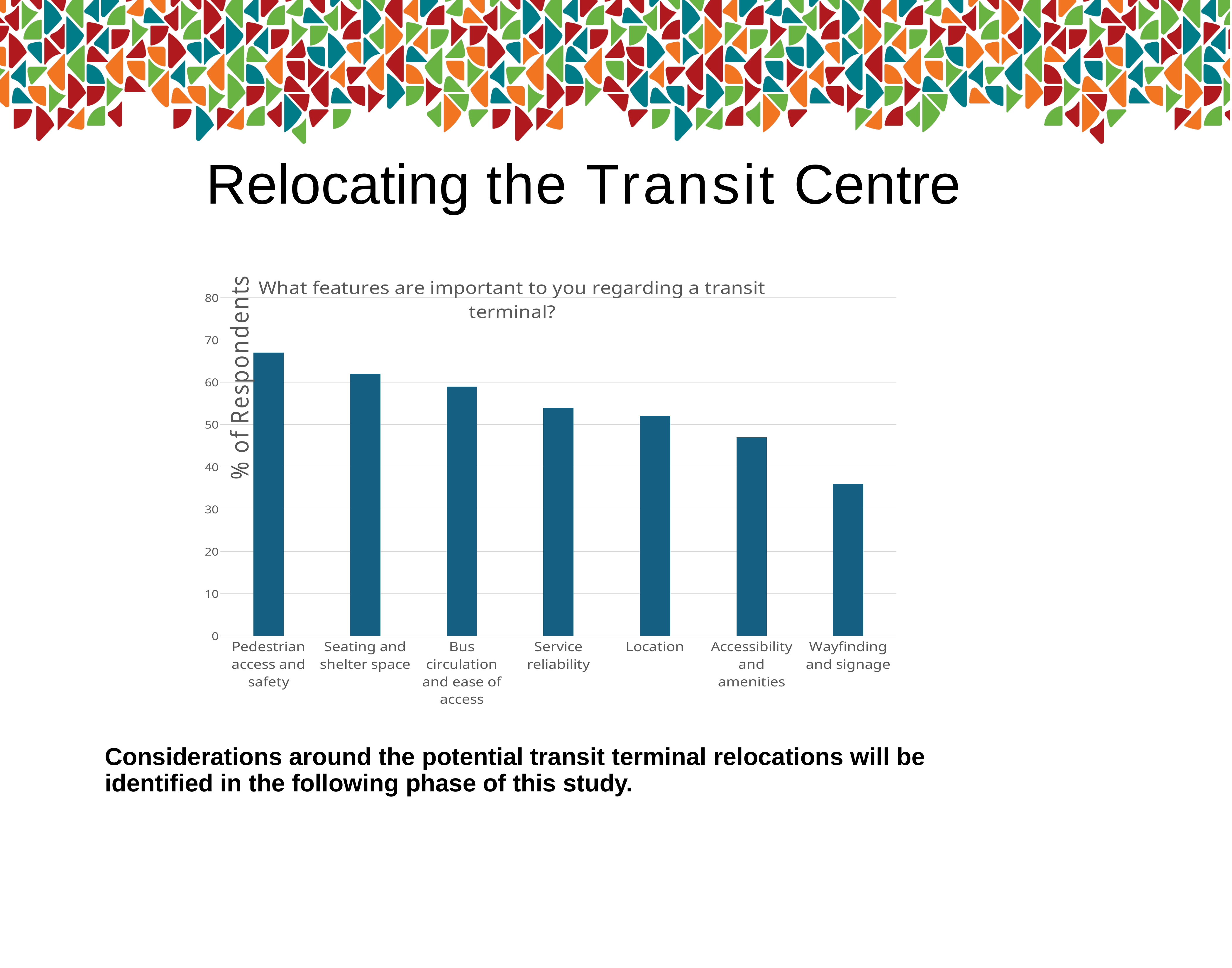
How many features (categories) are shown on the x axis? 7 Do the bar values rise or fall from left to right along the x axis? fall Is the value for Pedestrian access and safety greater or less than 60? greater What kind of chart is shown on the slide? bar chart Which feature has the lowest percentage of respondents? Wayfinding and signage Which feature has the highest percentage of respondents? Pedestrian access and safety Which is larger: the value for Service reliability or the value for Wayfinding and signage? Service reliability Is the value for Wayfinding and signage greater or less than 40? less Is the value for Accessibility and amenities greater or less than 50? less What is the title of the chart? What features are important to you regarding a transit terminal? What is the label on the y axis of the chart? % of Respondents